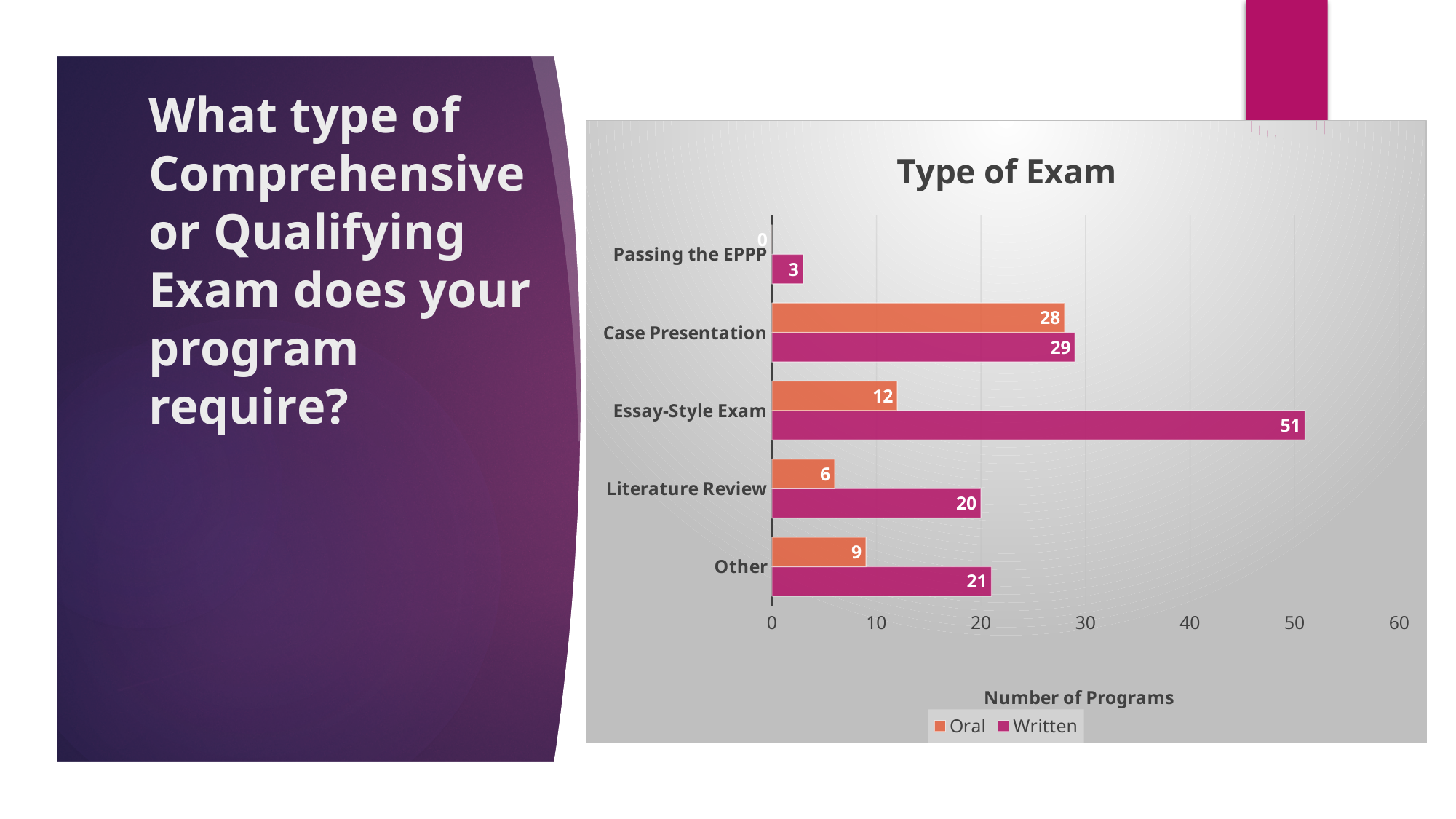
What is the x-axis label of the chart? Number of Programs How many series does the legend list? 2 How many categories are shown on the chart? 5 What is the Oral value for Case Presentation? 28 What is the Oral value for Passing the EPPP? 0 Which category has the lowest Written value? Passing the EPPP What kind of chart is shown? Bar chart What is the difference between the Written and Oral values for Essay-Style Exam? 39 Which is larger for Literature Review, the Oral value or the Written value? Written What is the Written value for Essay-Style Exam? 51 What is the title of the chart? Type of Exam Which category has the highest Written value? Essay-Style Exam